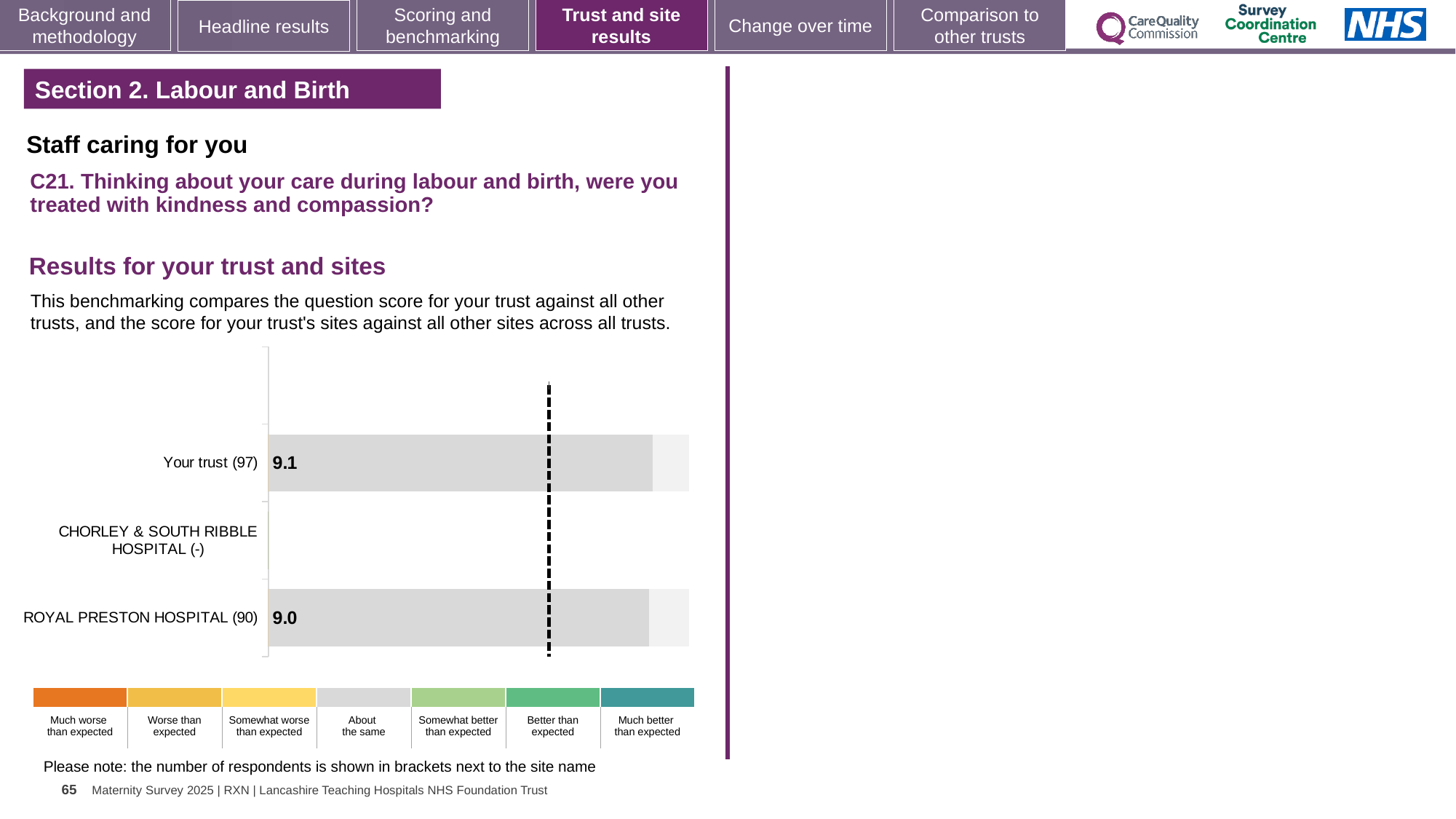
What is the score for ROYAL PRESTON HOSPITAL (90)? 9.0 What kind of chart is shown on the slide? Bar chart How many categories are listed on the vertical axis of the chart? 3 What is the score for Your trust (97)? 9.1 Which site on the chart has no bar plotted? CHORLEY & SOUTH RIBBLE HOSPITAL (-) How many respondents are shown in brackets for Your trust? 97 How many benchmark categories does the colour legend below the chart list? 7 Which category has the lowest plotted score on the chart? ROYAL PRESTON HOSPITAL (90) How many respondents are shown in brackets for ROYAL PRESTON HOSPITAL? 90 What is the difference between the score for Your trust (97) and the score for ROYAL PRESTON HOSPITAL (90)? 0.1 Which has the higher score, Your trust (97) or ROYAL PRESTON HOSPITAL (90)? Your trust (97)